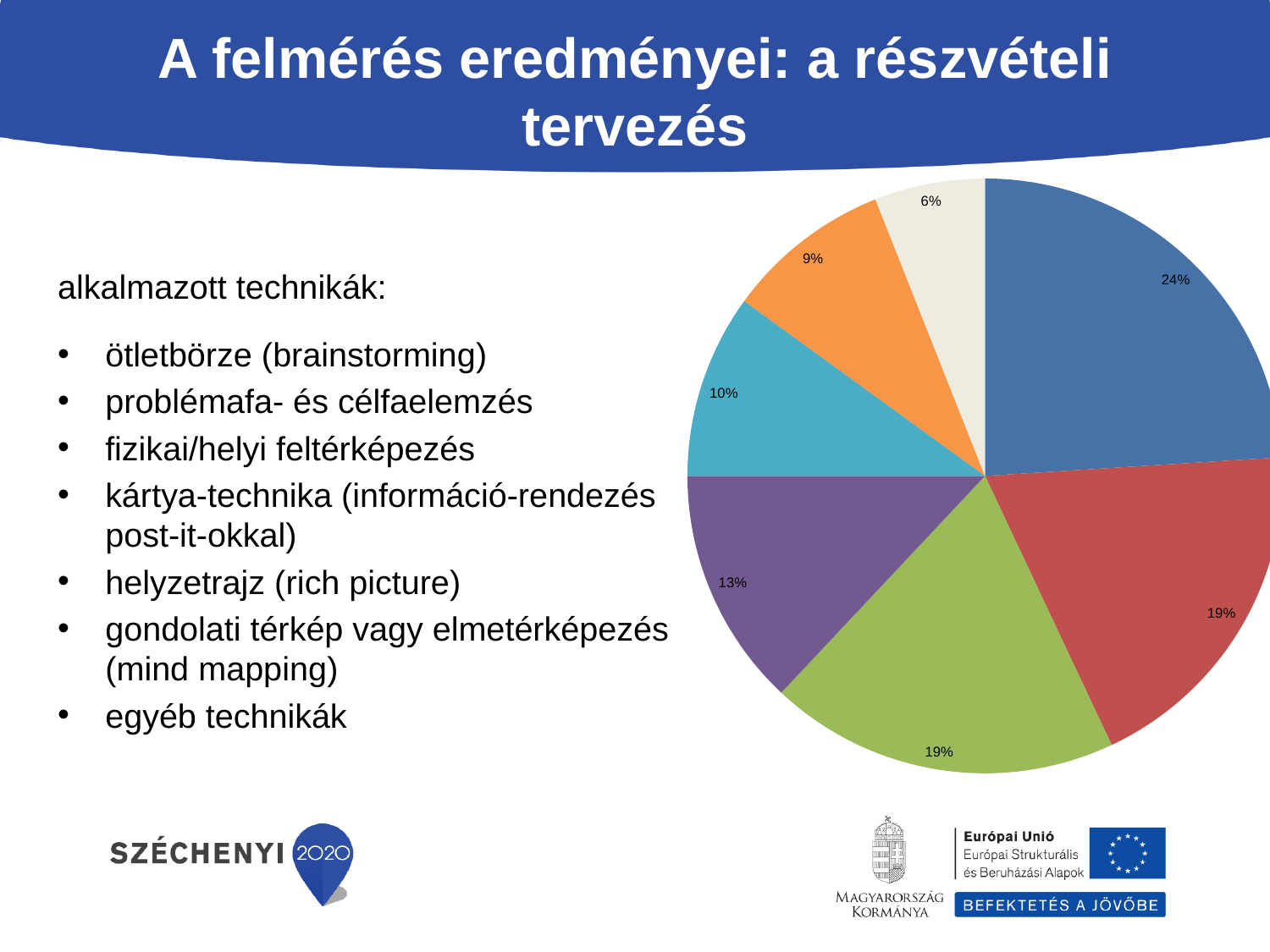
What kind of chart is shown on the slide? pie chart How many slices does the pie chart have? 7 What is the value of the largest slice of the pie chart? 24% What percentage is shown on the orange slice of the pie chart? 9% Which slice is larger, the purple one or the light blue one? the purple one What is the difference between the dark blue slice (24%) and the purple slice (13%)? 11% What do the red slice and the green slice of the pie chart add up to? 38% What percentage is shown on the light blue slice of the pie chart? 10% What percentage is shown on the dark blue slice of the pie chart? 24% What is the value of the smallest slice of the pie chart? 6% Does the pie chart have a legend? No What percentage is shown on the purple slice of the pie chart? 13%